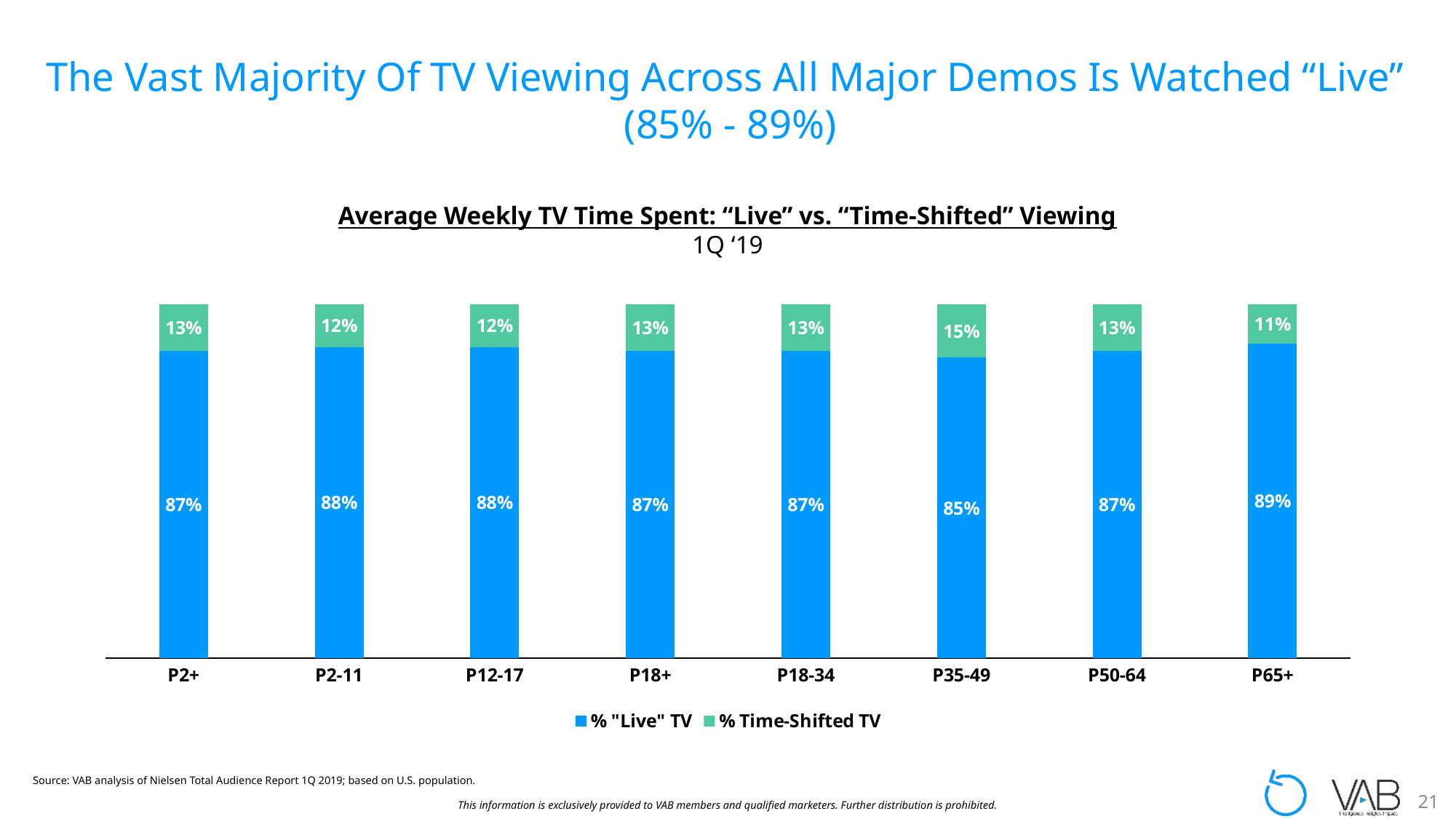
What is the % "Live" TV value for P2-11? 88% Which demo has the highest % "Live" TV value? P65+ How many series does the legend list? 2 What is the total of the stacked bar for P18-34? 100% What is the % "Live" TV value for P35-49? 85% What kind of chart is shown on the slide? Stacked bar chart What is the % Time-Shifted TV value for P65+? 11% Which demo has the highest % Time-Shifted TV value? P35-49 Which is larger, the % Time-Shifted TV value for P2+ or for P12-17? P2+ Which demo has the lowest % "Live" TV value? P35-49 What is the difference between the % "Live" TV values for P65+ and P35-49? 4% How many demo categories are shown on the x axis? 8